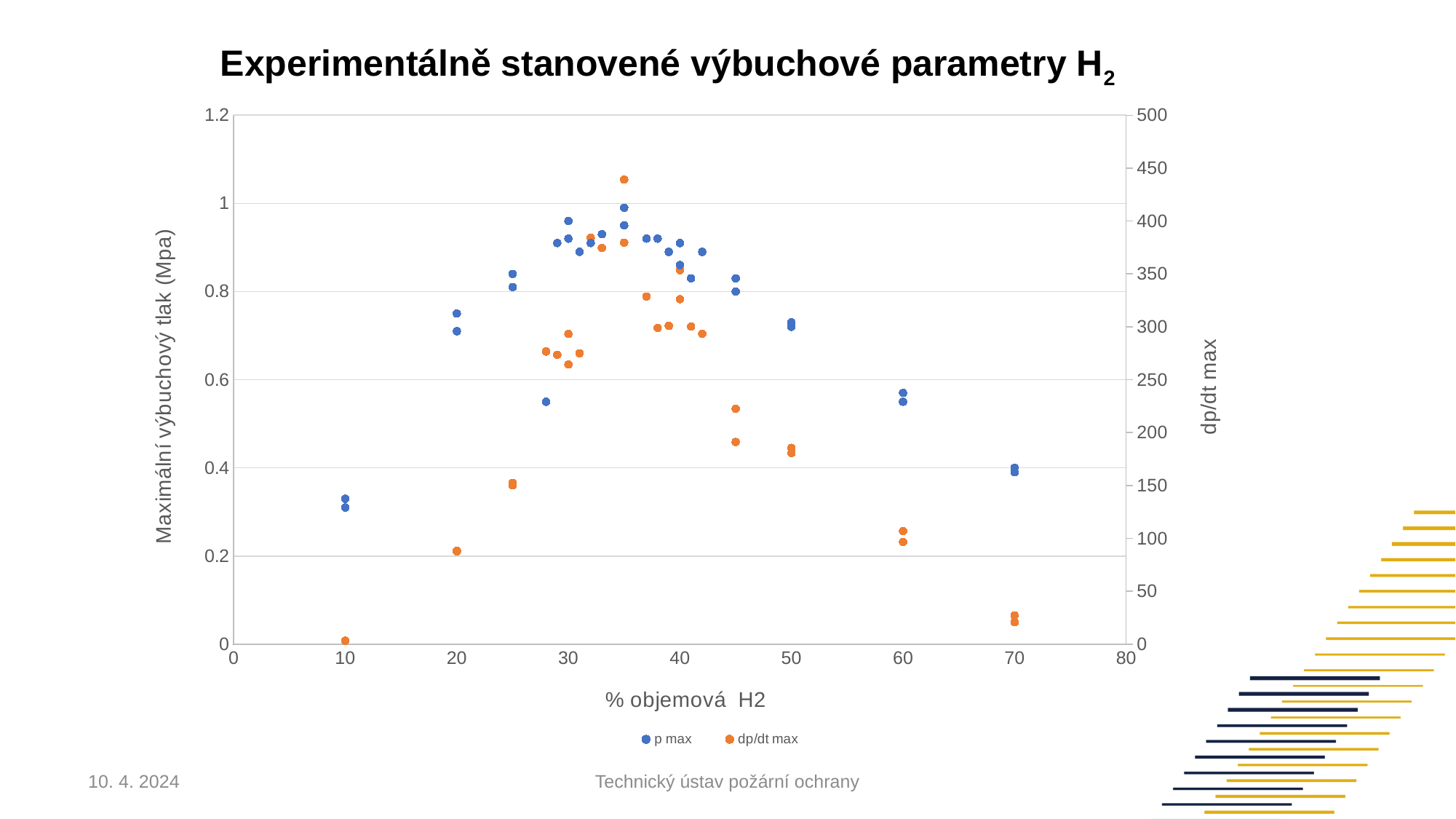
How many series does the legend list? 2 Is the dp/dt max value at 70 % objemová H2 greater or less than 50? less Is the p max value at 10 % objemová H2 greater or less than 0.4? less What kind of chart is shown on the slide? scatter chart Do the p max values rise or fall as the H2 concentration increases from 35 % to 70 %? fall Which is larger, p max at 20 % objemová H2 or p max at 60 % objemová H2? p max at 20 % At which H2 concentration (% objemová) is dp/dt max lowest? 10 At which H2 concentration (% objemová) does dp/dt max reach its highest value? 35 What are the two series named in the legend? p max and dp/dt max At which H2 concentration (% objemová) does p max reach its highest value? 35 What is the title of the left vertical axis? Maximální výbuchový tlak (Mpa)